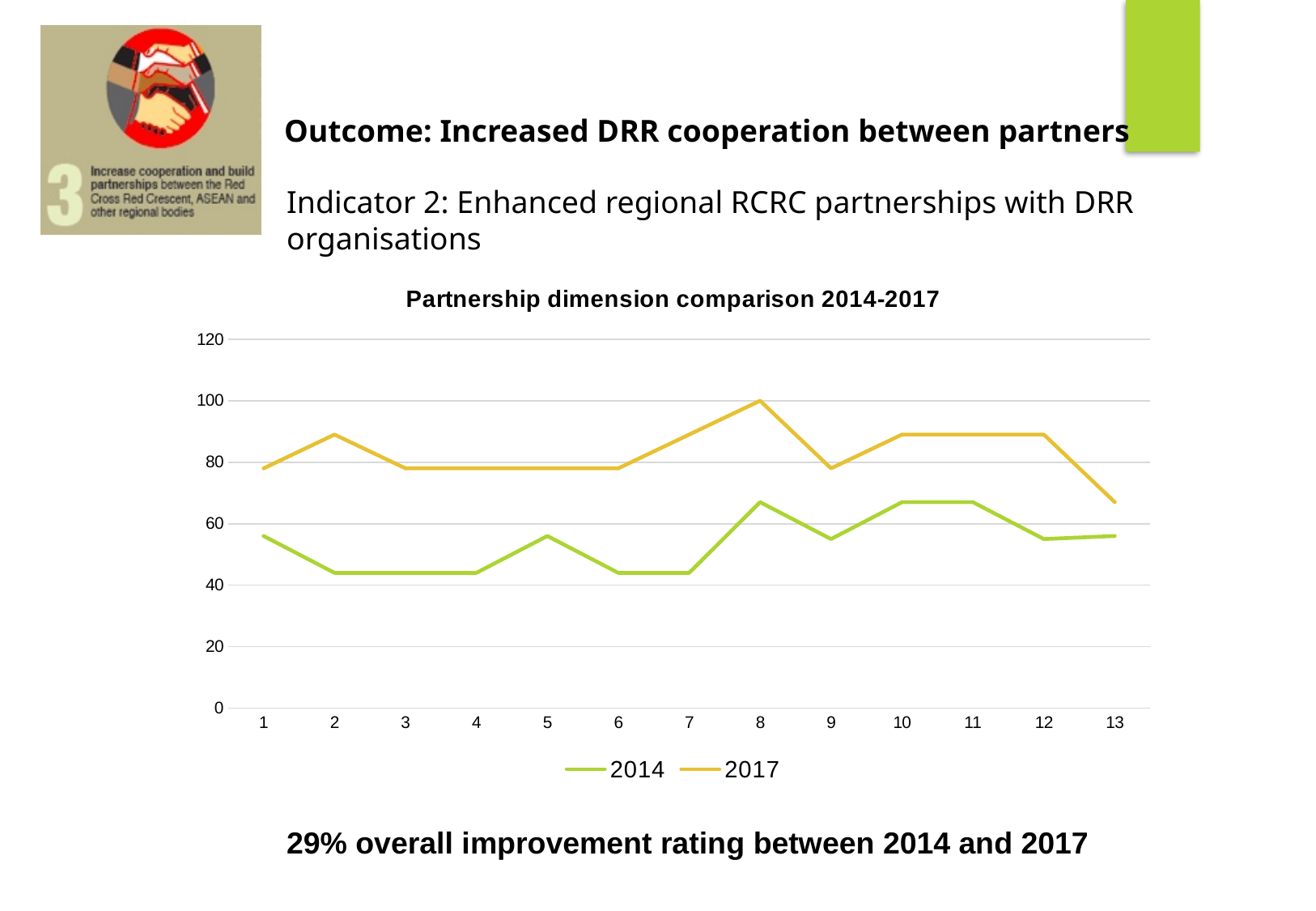
How many points are plotted along the x axis for each series? 13 At which point does the 2017 series reach its lowest value? 13 Is the value for the 2017 series at point 2 greater or less than 80? greater How many series does the chart legend list? 2 What is the value of the 2017 series at point 8? 100 Is the value for the 2017 series at point 13 greater or less than 80? less At point 8, which series has the larger value, 2014 or 2017? 2017 What is the title of the chart? Partnership dimension comparison 2014-2017 Does the 2017 series rise or fall from point 12 to point 13? fall What kind of chart is shown on the slide? line chart Is the value for the 2014 series at point 2 greater or less than 60? less At which point does the 2017 series reach its highest value? 8